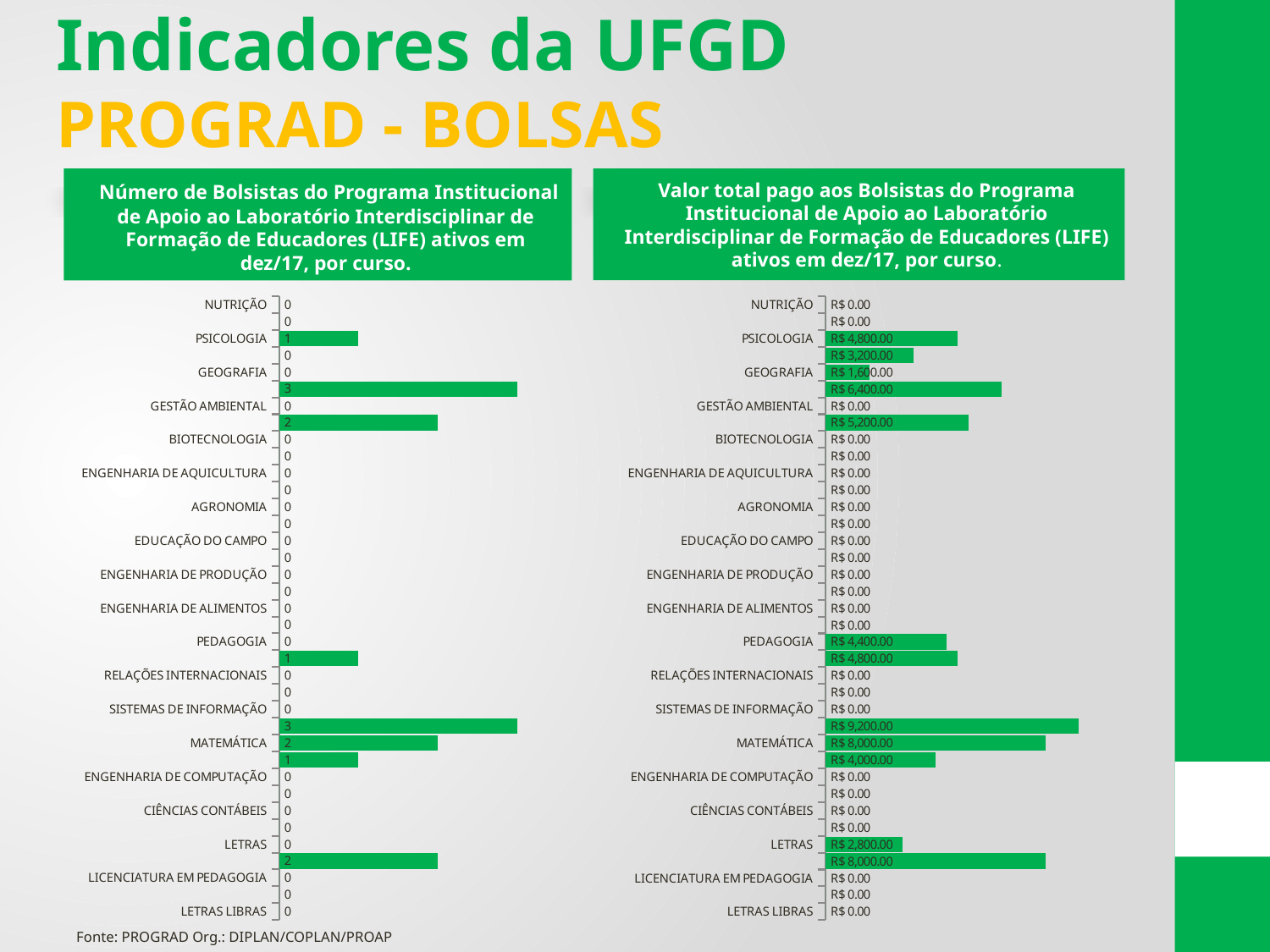
On the right chart (Valor total pago), what is the difference between the value for MATEMÁTICA and the value for PSICOLOGIA? R$ 3,200.00 On the right chart (Valor total pago), what is the value for PEDAGOGIA? R$ 4,400.00 On the left chart (Número de Bolsistas), what is the value for PSICOLOGIA? 1 What is the largest data label shown on the right chart (Valor total pago)? R$ 9,200.00 On the left chart (Número de Bolsistas), what is the difference between the value for MATEMÁTICA and the value for PSICOLOGIA? 1 What kind of chart is used on the right side of the slide (Valor total pago)? Bar chart On the right chart (Valor total pago), what is the value for LETRAS? R$ 2,800.00 On the right chart (Valor total pago), what is the value for PSICOLOGIA? R$ 4,800.00 On the left chart (Número de Bolsistas), what is the value for LETRAS LIBRAS? 0 On the left chart (Número de Bolsistas), what is the value for MATEMÁTICA? 2 On the right chart (Valor total pago), what is the value for GEOGRAFIA? R$ 1,600.00 On the right chart (Valor total pago), which is larger, the value for MATEMÁTICA or the value for PSICOLOGIA? MATEMÁTICA